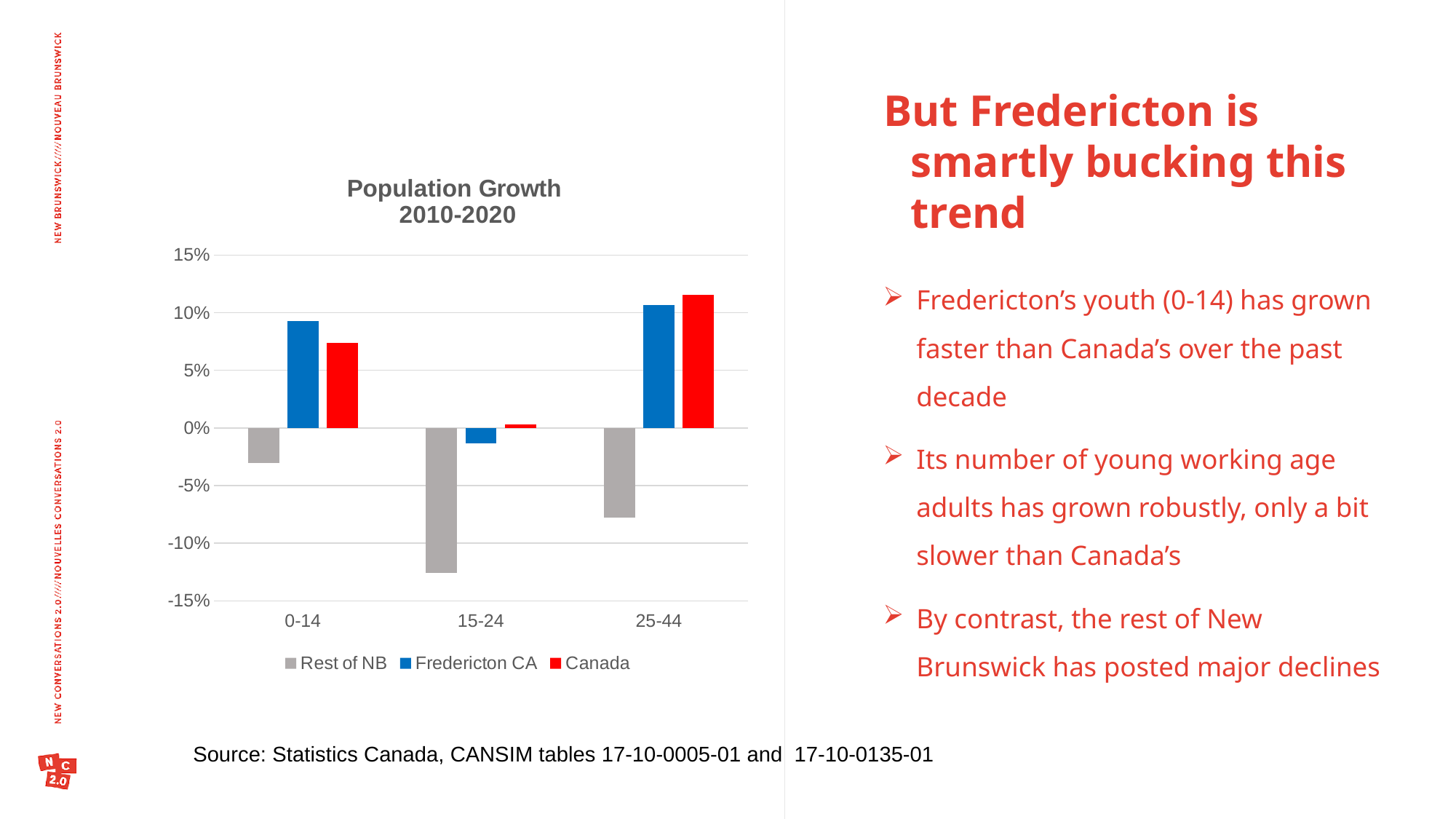
Which age group has the highest value for Canada? 25-44 Is the Fredericton CA value for the 0-14 age group greater or less than 5%? greater Which age group has the lowest value for Rest of NB? 15-24 Is the Canada value for the 25-44 age group greater or less than 10%? greater What kind of chart is shown on the slide? bar chart What colour represents the Canada series in the chart? red Is the Rest of NB value for the 25-44 age group greater or less than -5%? less How many series does the legend of the Population Growth 2010-2020 chart list? 3 For the 0-14 age group, which is larger: Fredericton CA or Canada? Fredericton CA What is the title of the chart? Population Growth 2010-2020 How many age groups are shown on the x axis of the chart? 3